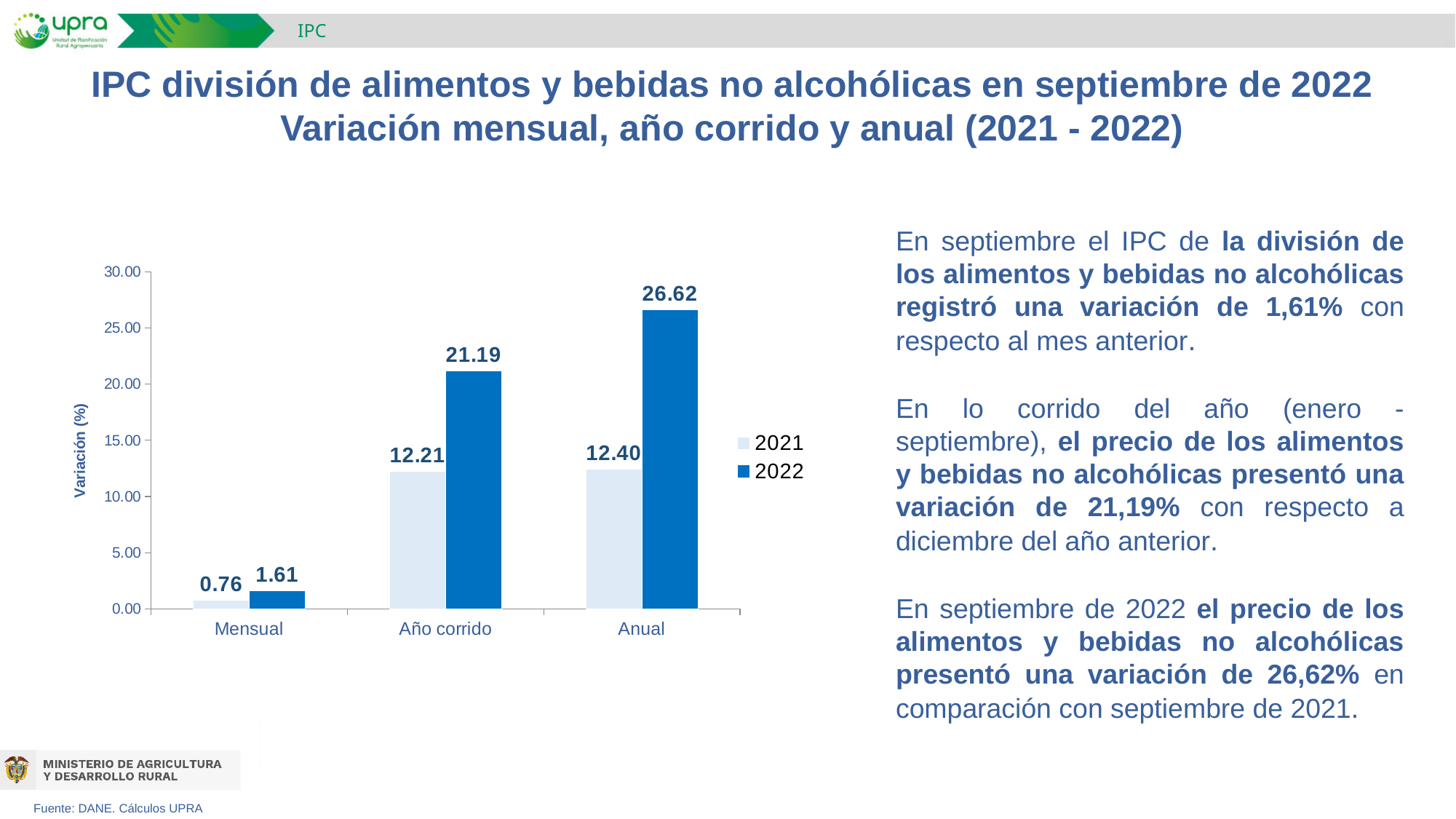
How many categories are shown on the x axis? 3 Which is larger: the 2022 value for Año corrido or the 2021 value for Anual? 2022 value for Año corrido What is the difference between the 2022 and 2021 values in the Anual category? 14.22 How many series does the legend list? 2 Which category has the highest value for the 2022 series? Anual Which category has the lowest value for the 2021 series? Mensual What is the value for 2022 in the Mensual category? 1.61 What kind of chart is shown on the slide? Bar chart What is the label of the y axis? Variación (%) What is the difference between the 2022 and 2021 values in the Año corrido category? 8.98 What is the value for 2021 in the Anual category? 12.40 What is the value for 2021 in the Año corrido category? 12.21